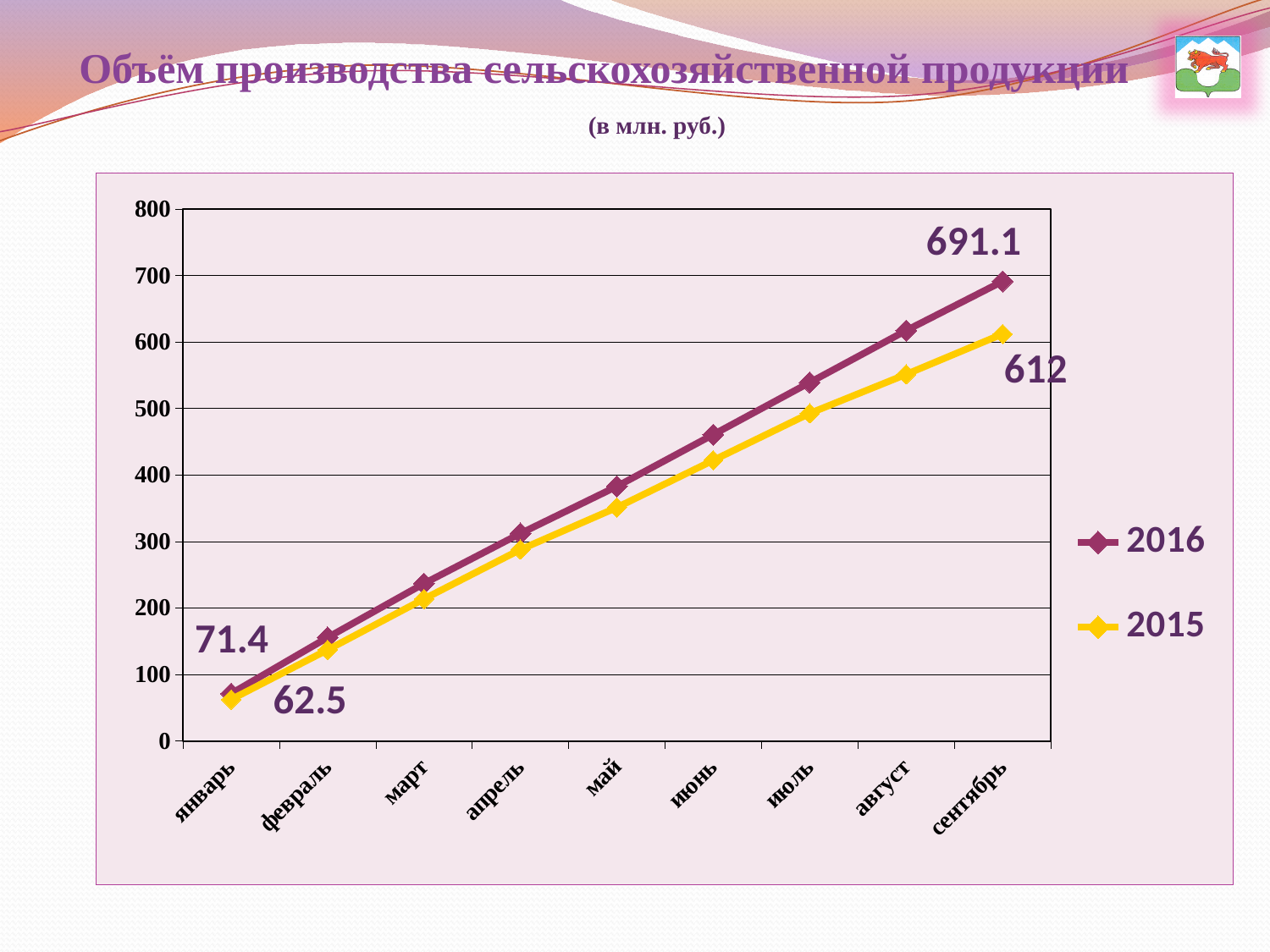
What is the value for 2016 in сентябрь? 691.1 Is the value for 2015 in май greater or less than 400? less Do the values for 2016 rise or fall from январь to сентябрь? rise What is the difference between the 2016 and 2015 values in сентябрь? 79.1 What is the value for 2015 in январь? 62.5 What type of chart is shown on the slide? line chart How many months are shown on the x axis? 9 How many series does the legend list? 2 What is the value for 2015 in сентябрь? 612 What is the difference between the 2016 and 2015 values in январь? 8.9 Which series has the higher value in сентябрь, 2016 or 2015? 2016 What is the value for 2016 in январь? 71.4